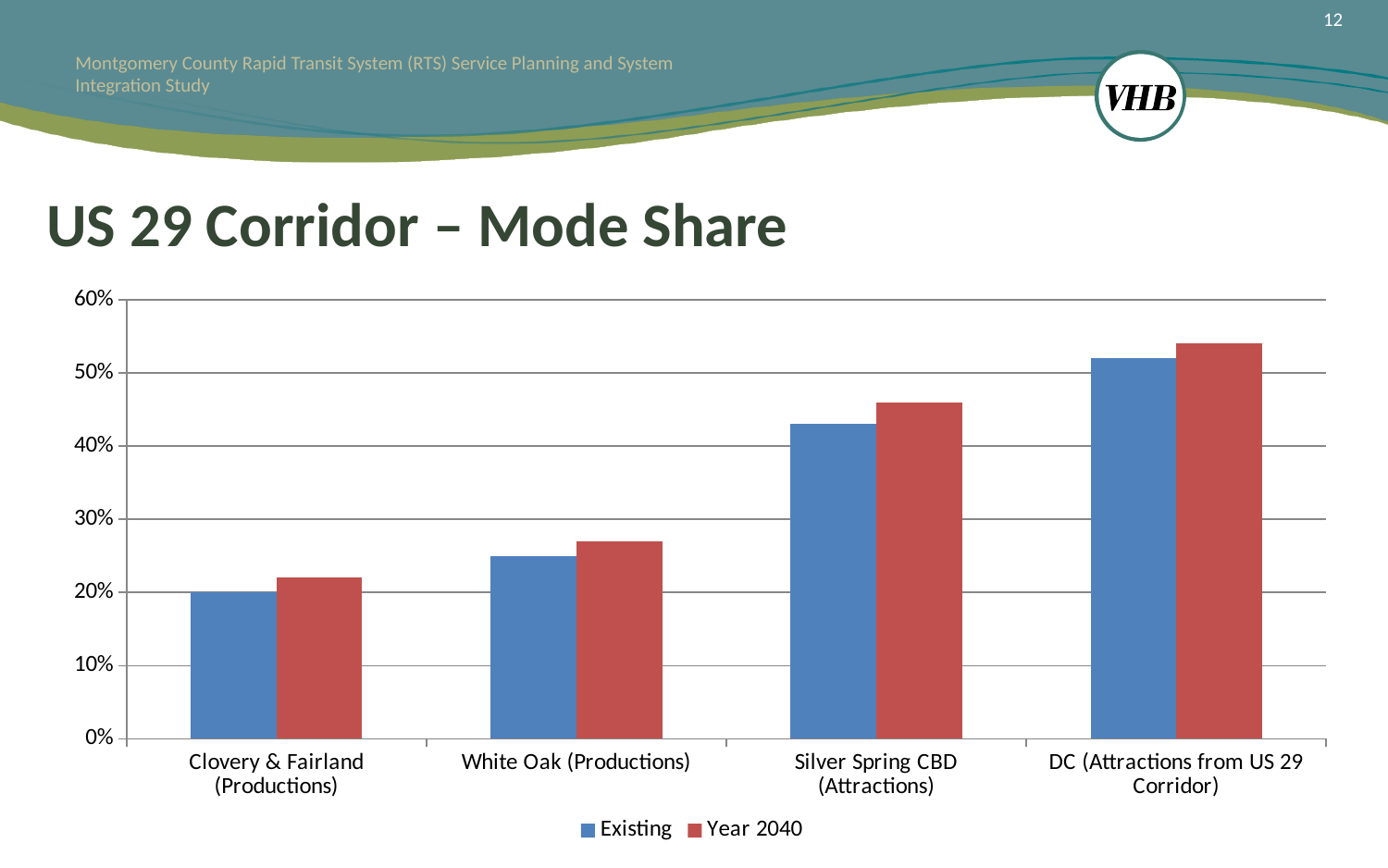
Which category has the highest mode share for the Year 2040 series? DC (Attractions from US 29 Corridor) Is the Year 2040 value for DC (Attractions from US 29 Corridor) greater or less than 50%? greater How many series does the chart's legend list? 2 Is the Year 2040 value for White Oak (Productions) greater or less than 30%? less Is the Existing value for Silver Spring CBD (Attractions) greater or less than 40%? greater Which category has the lowest mode share for the Existing series? Clovery & Fairland (Productions) For White Oak (Productions), which is larger: the Existing value or the Year 2040 value? Year 2040 How many categories are shown on the x axis of the chart? 4 What kind of chart is shown on the slide? Bar chart Do the Existing values rise or fall moving from left to right across the categories? Rise What are the two series named in the chart's legend? Existing and Year 2040